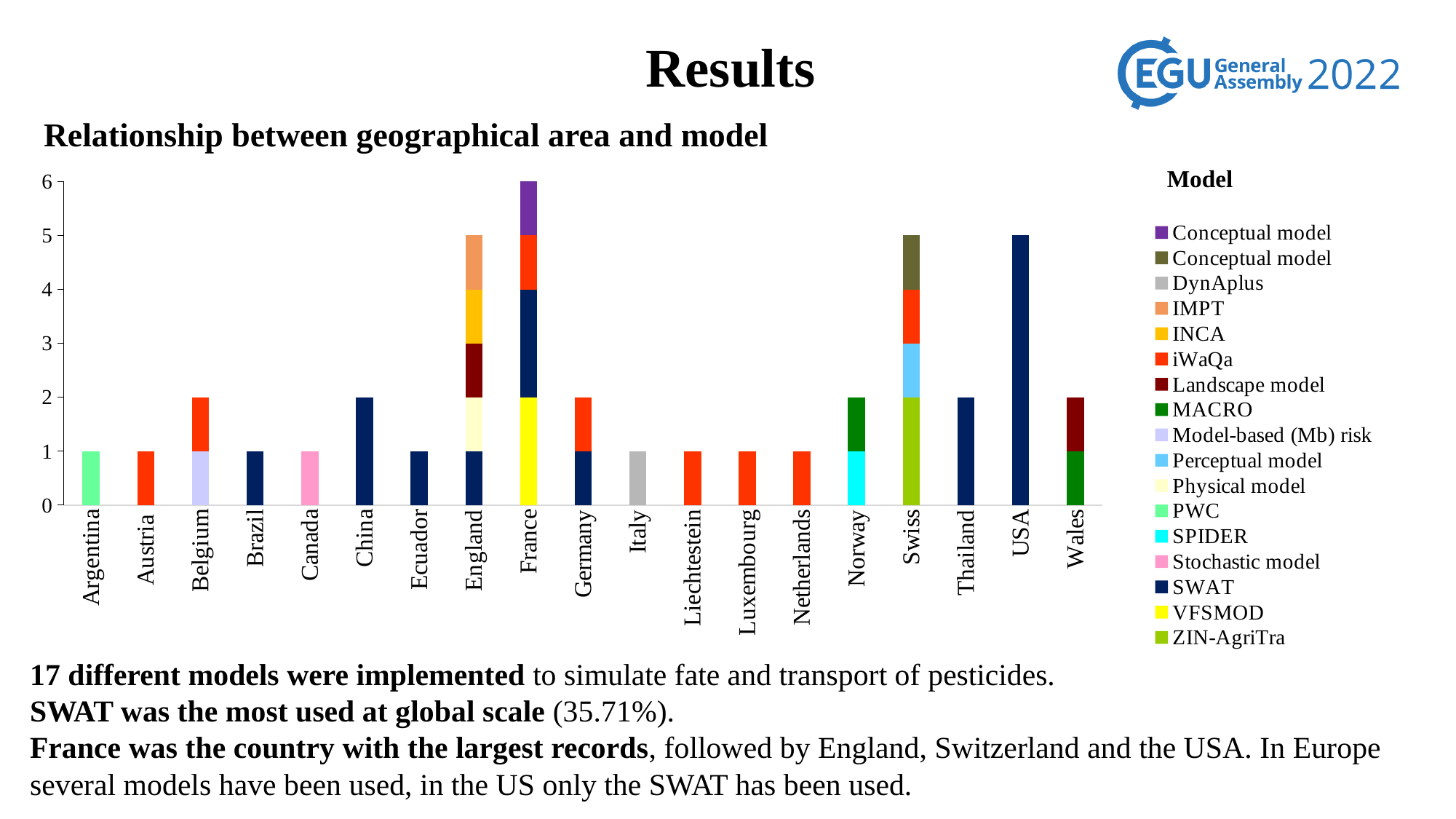
What is the value of the SWAT segment for USA? 5 Is the total value for France greater or less than 5? greater Which model is represented by the yellow colour in the legend? VFSMOD What is the total value of the bar for France? 6 What is the total value of the bar for USA? 5 What is the difference between the total for France and the total for Swiss? 1 How many entries does the Model legend list? 17 What kind of chart is shown on the slide? Stacked bar chart How many countries are shown on the x axis? 19 Which country has the highest total number of records in the chart? France What is the total value of the bar for England? 5 Which has a larger total, Belgium or Austria? Belgium